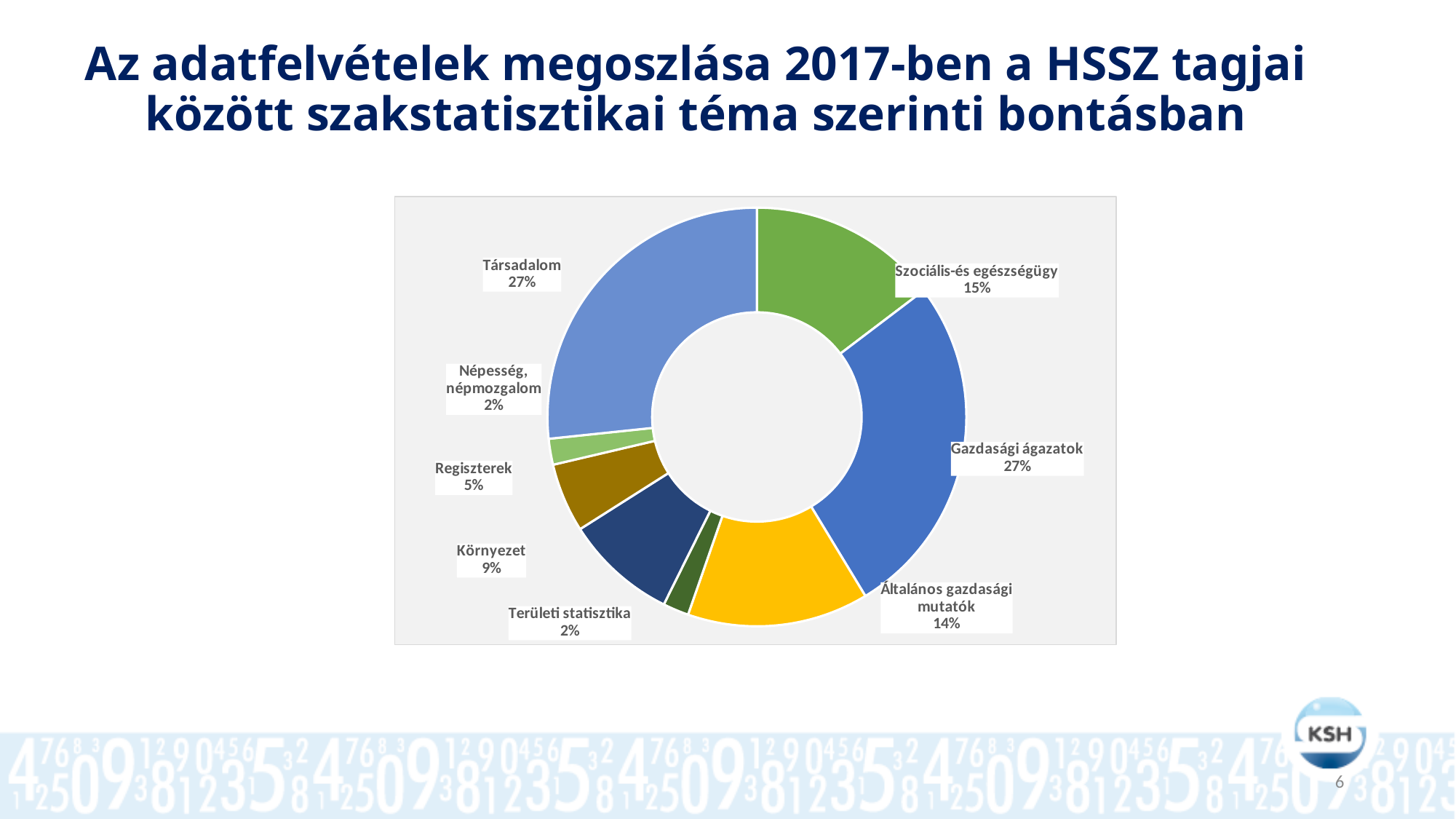
What share is shown for Általános gazdasági mutatók? 14% How many categories are shown in the chart? 8 What percentage is shown for Szociális-és egészségügy? 15% Which is larger, Szociális-és egészségügy or Általános gazdasági mutatók? Szociális-és egészségügy Which is larger, the share for Környezet or the share for Regiszterek? Környezet What is the difference in percentage points between Gazdasági ágazatok and Általános gazdasági mutatók? 13 What is the difference in percentage points between Környezet and Területi statisztika? 7 What percentage is labelled for Regiszterek? 5% What kind of chart is shown on the slide? Doughnut (pie) chart What is the value labelled for Környezet? 9% What share does Társadalom have? 27% What share does Gazdasági ágazatok have in the chart? 27%